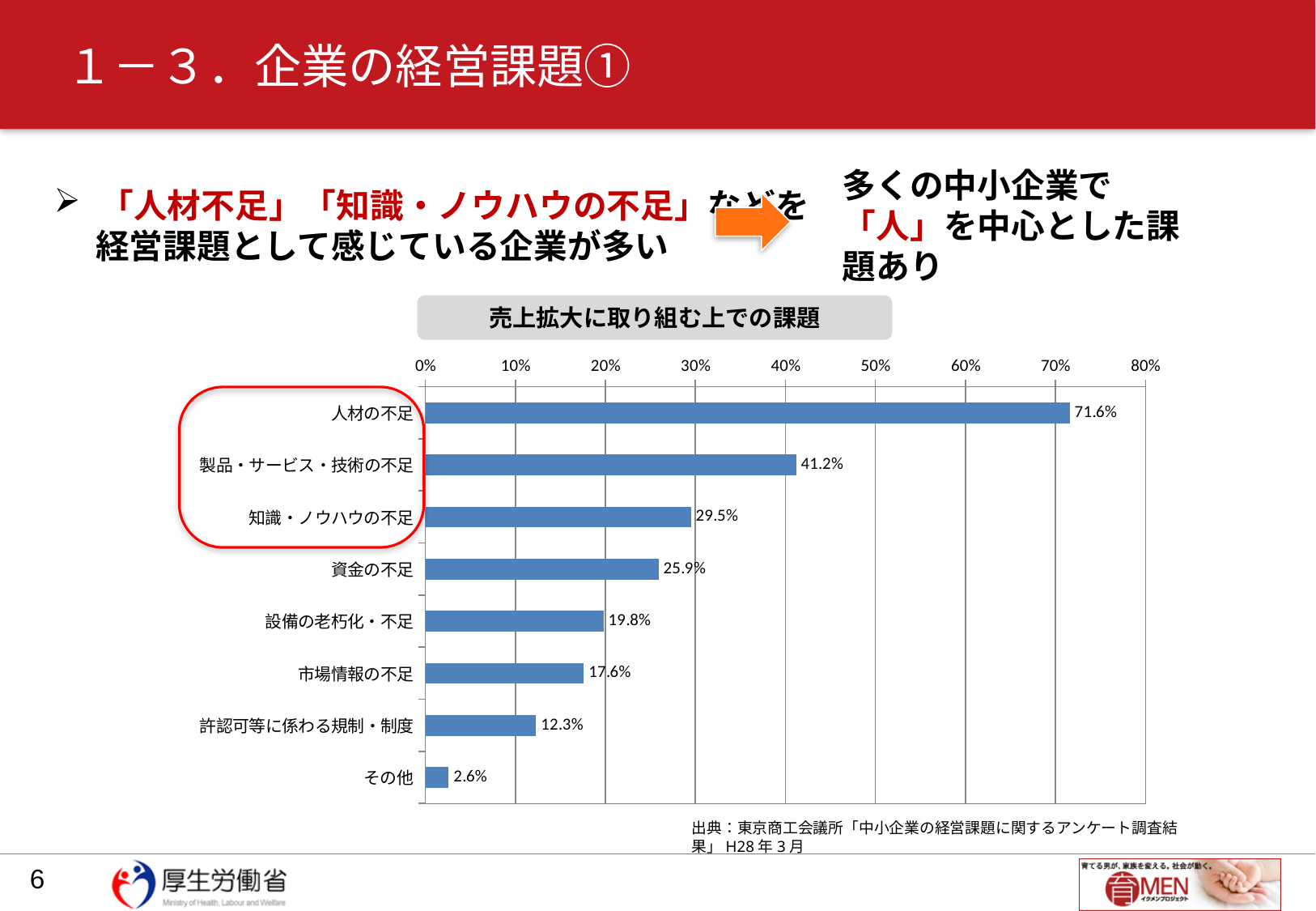
Is the value for 製品・サービス・技術の不足 greater or less than 40%? greater What is the value for 許認可等に係わる規制・制度? 12.3% What is the title of the chart? 売上拡大に取り組む上での課題 What is the difference between 人材の不足 and 製品・サービス・技術の不足? 30.4% Which is larger, 資金の不足 or 設備の老朽化・不足? 資金の不足 How many categories are shown in the chart? 8 What is the value for 人材の不足? 71.6% Which category has the lowest value? その他 What is the value for 知識・ノウハウの不足? 29.5% What is the value for 市場情報の不足? 17.6% Which category has the highest value? 人材の不足 What kind of chart is shown? bar chart